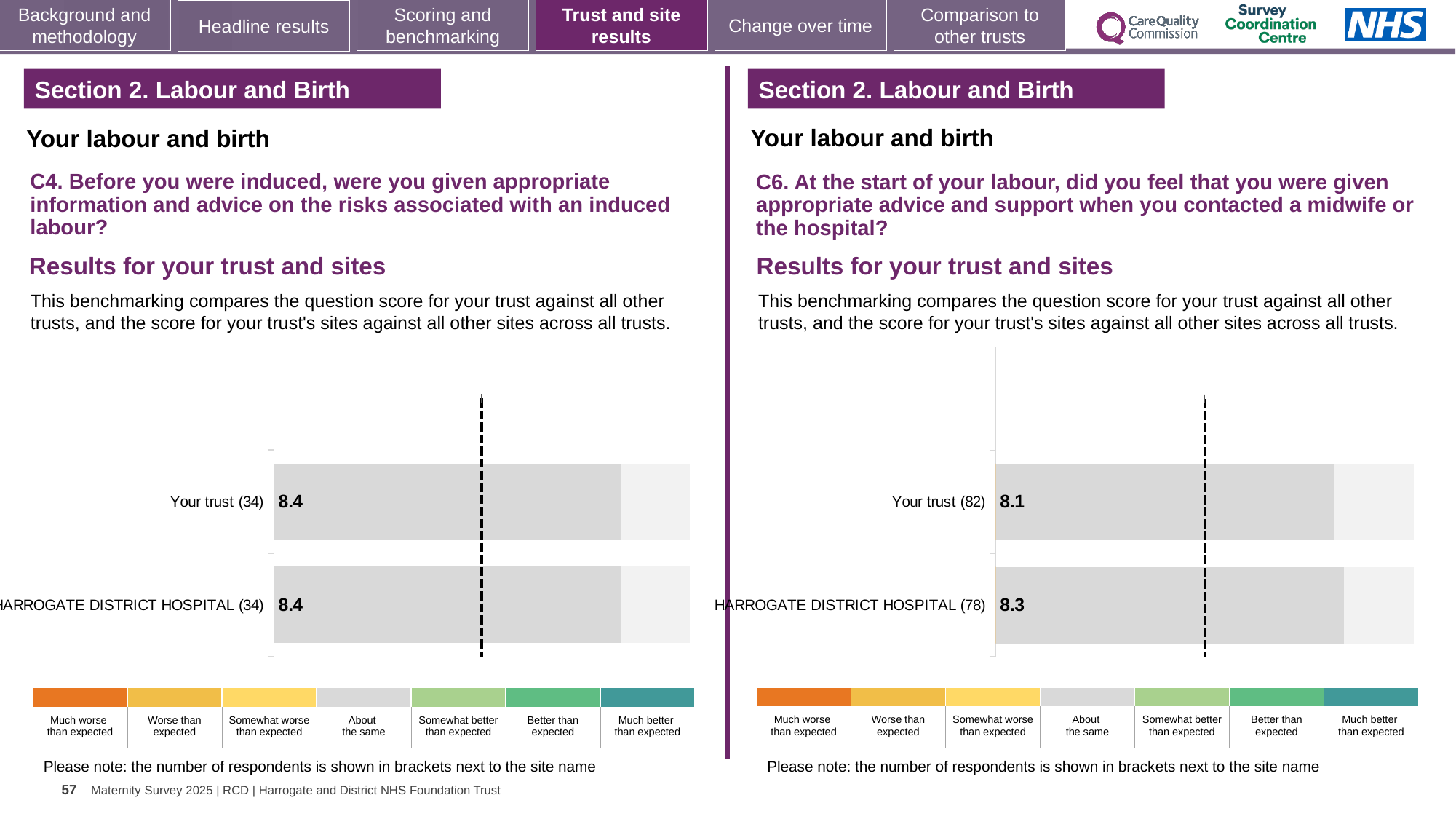
In the left chart (C4), how many respondents are shown in brackets for HARROGATE DISTRICT HOSPITAL? 34 In the right chart (C6), how many respondents are shown in brackets for Your trust? 82 In the left chart (C4), what is the difference between the Your trust score and the HARROGATE DISTRICT HOSPITAL score? 0 In the right chart (C6), what is the difference between the HARROGATE DISTRICT HOSPITAL score and the Your trust score? 0.2 In the right chart (C6), which bar has the lowest score? Your trust What type of chart is used on the right side of the slide (C6)? Bar chart In the right chart (C6), which has the higher score, Your trust or HARROGATE DISTRICT HOSPITAL? HARROGATE DISTRICT HOSPITAL In the right chart (C6), what is the score for Your trust? 8.1 In the left chart (C4), what is the score for HARROGATE DISTRICT HOSPITAL? 8.4 In the left chart (C4), what is the score for Your trust? 8.4 In the right chart (C6), what is the score for HARROGATE DISTRICT HOSPITAL? 8.3 How many bars are plotted in the left chart (C4)? 2